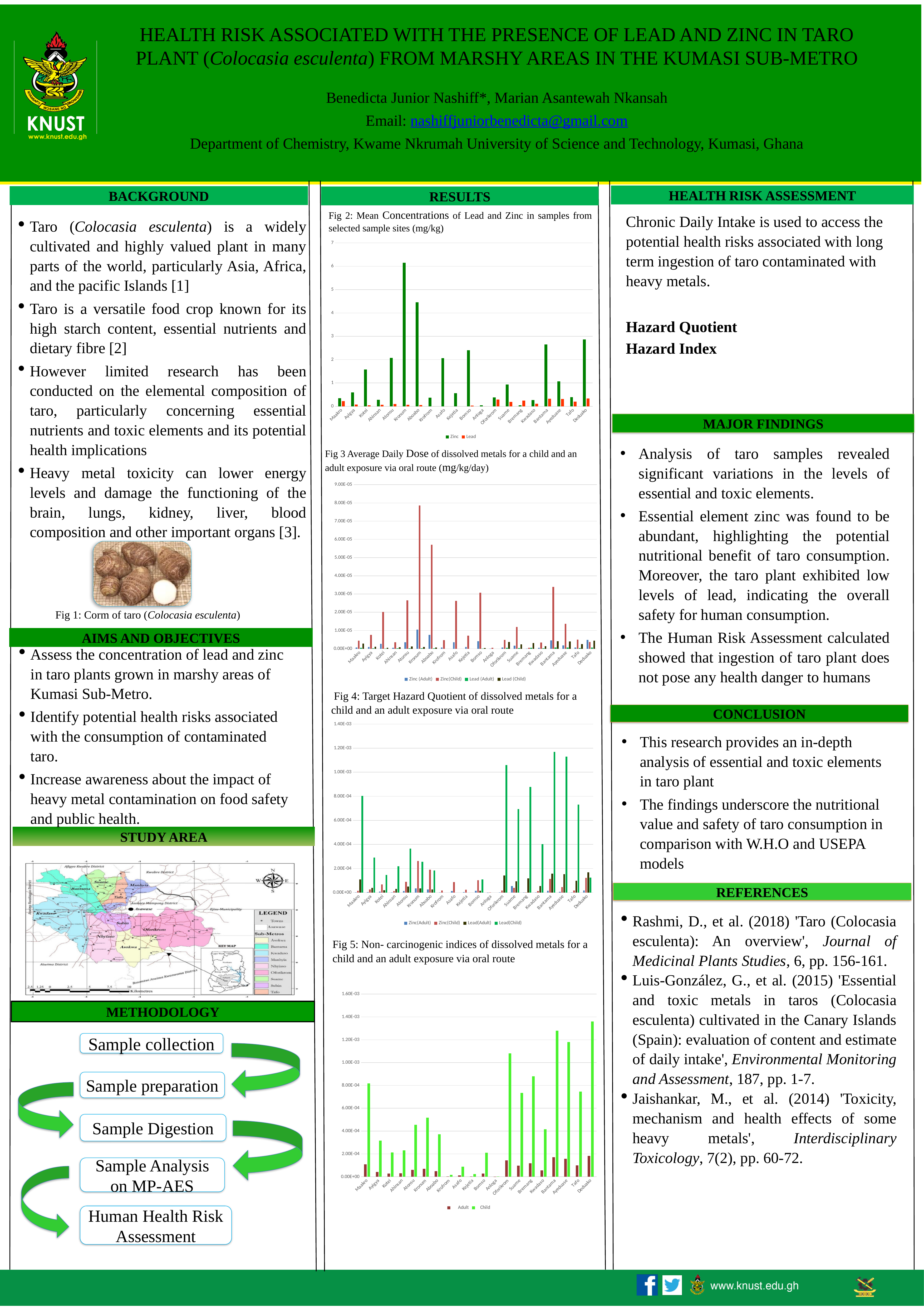
In Fig 2 (Mean Concentrations of Lead and Zinc), is the zinc value for Kronum greater or less than 5? greater In Fig 2 (Mean Concentrations of Lead and Zinc), is the zinc value for Aboabo greater or less than 4? greater In Fig 4 (Target Hazard Quotient), is the Lead(Child) value for Bantama greater or less than 1.00E-03? greater In Fig 3 (Average Daily Dose of dissolved metals), which sample site has the highest Zinc(Child) value? Kronum In Fig 2 (Mean Concentrations of Lead and Zinc), how many sample sites are shown on the x axis? 20 In Fig 5 (Non-carcinogenic indices), what are the two series listed in the legend? Adult and Child In Fig 2 (Mean Concentrations of Lead and Zinc), what kind of chart is used? bar chart In Fig 2 (Mean Concentrations of Lead and Zinc), which sample site has the highest zinc concentration? Kronum In Fig 2 (Mean Concentrations of Lead and Zinc), which is larger, the zinc value for Kronum or the zinc value for Aboabo? Kronum In Fig 2 (Mean Concentrations of Lead and Zinc), how many series does the legend list? 2 In Fig 3 (Average Daily Dose of dissolved metals), how many series does the legend list? 4